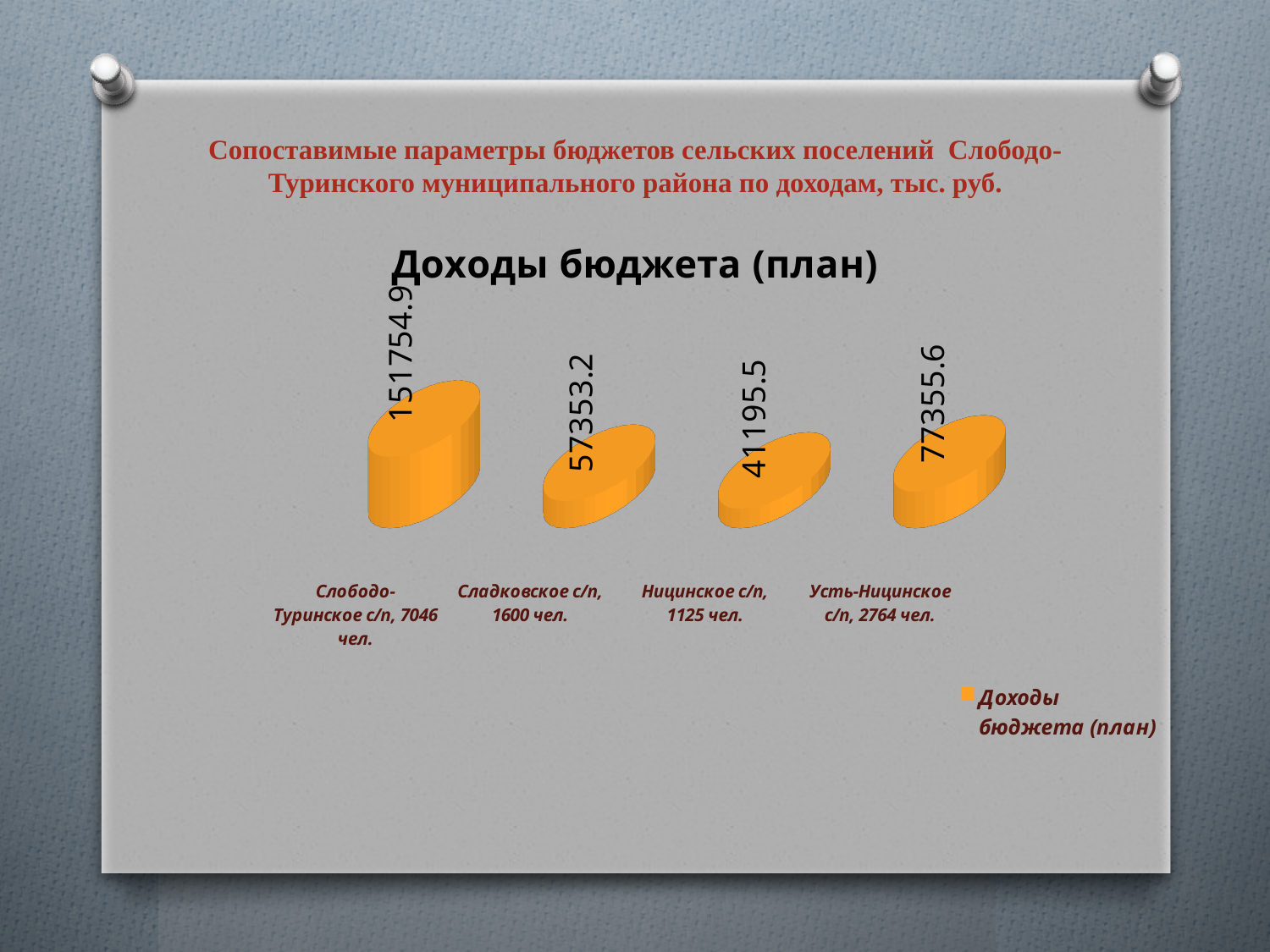
Which category has the highest value? Слободо-Туринское с/п Which is larger, the value for Сладковское с/п or the value for Усть-Ницинское с/п? Усть-Ницинское с/п How many categories are shown in the chart? 4 What is the value for Ницинское с/п? 41195.5 Which category has the lowest value? Ницинское с/п How many series does the legend list? 1 What is the value for Слободо-Туринское с/п? 151754.9 What is the value for Сладковское с/п? 57353.2 What is the title of the chart? Доходы бюджета (план) What is the difference between the values for Усть-Ницинское с/п and Ницинское с/п? 36160.1 What is the value for Усть-Ницинское с/п? 77355.6 What is the difference between the values for Слободо-Туринское с/п and Сладковское с/п? 94401.7